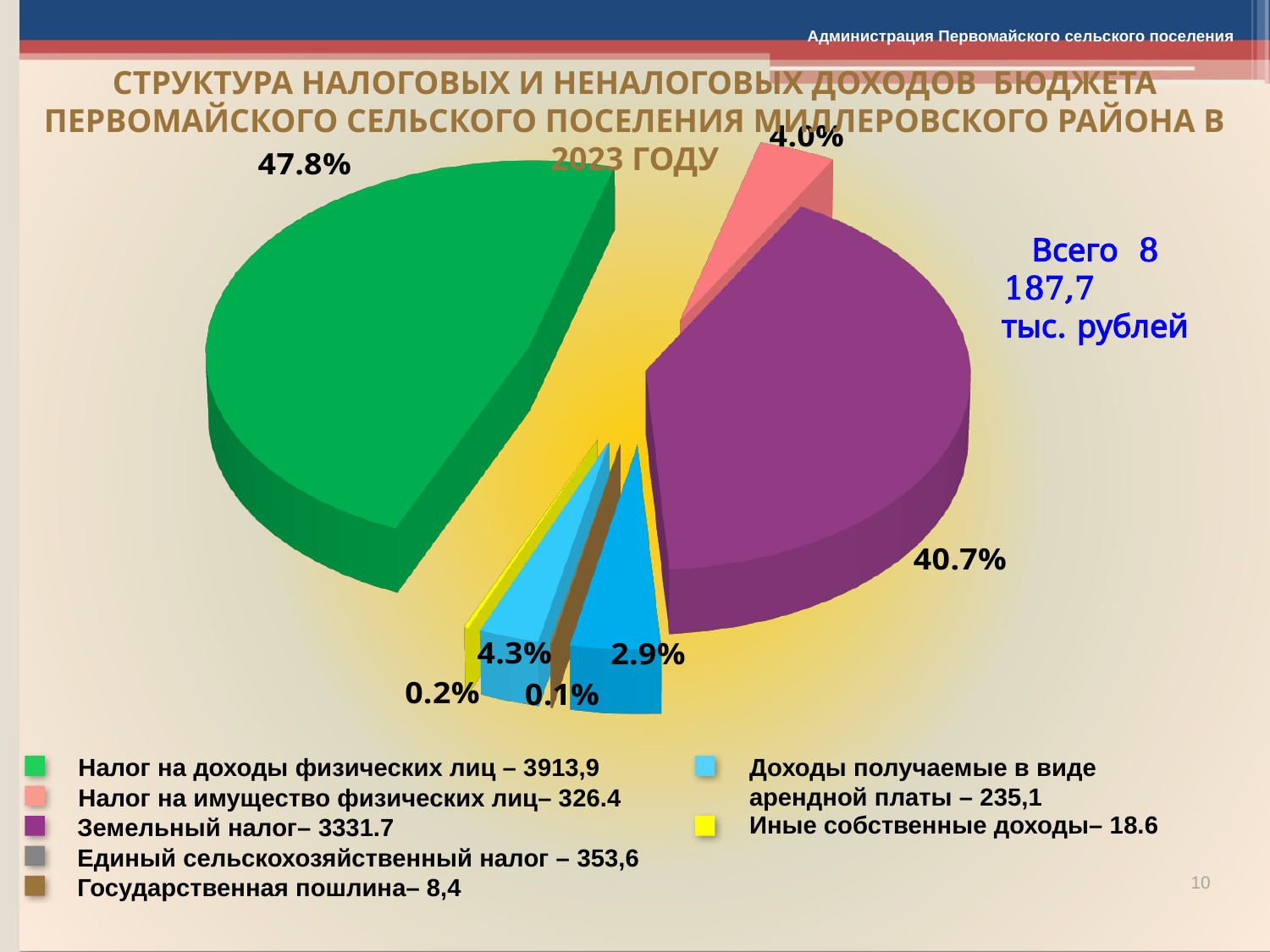
Which category has the largest share of the pie? Налог на доходы физических лиц Which is larger: the share for Налог на доходы физических лиц or the share for Земельный налог? Налог на доходы физических лиц What is the value for Единый сельскохозяйственный налог given in the legend? 353,6 How many slices does the pie chart have? 7 Which category has the smallest share of the pie? Государственная пошлина What is the value for Иные собственные доходы given in the legend? 18.6 What share of the pie does the purple slice (Земельный налог) represent? 40.7% What share of the pie does the green slice (Налог на доходы физических лиц) represent? 47.8% What share of the pie does the pink slice (Налог на имущество физических лиц) represent? 4.0% What is the value for Земельный налог given in the legend? 3331.7 What total amount is stated next to the pie chart? 8 187,7 тыс. рублей What kind of chart is shown on the slide? pie chart